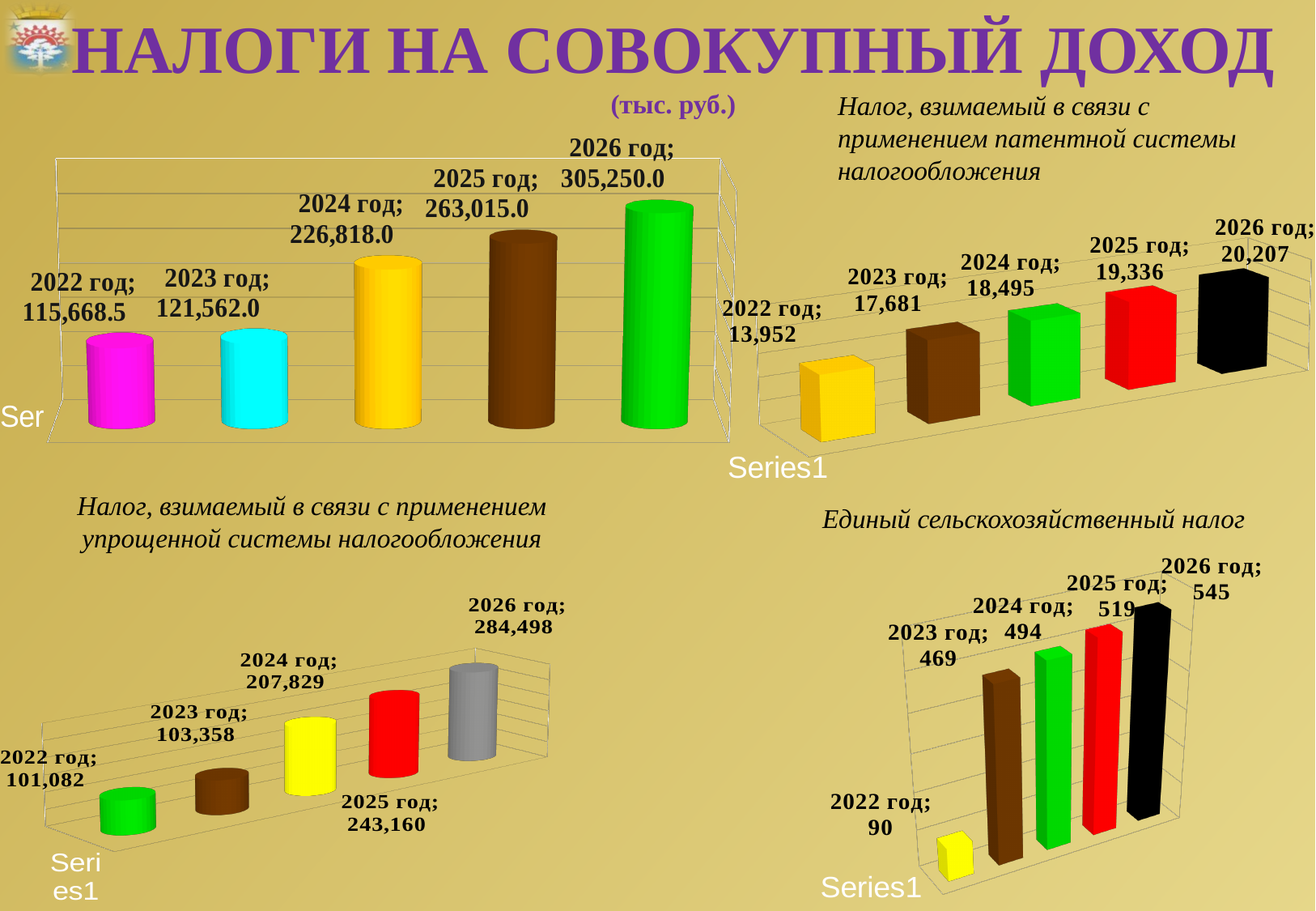
In the chart titled 'Налог, взимаемый в связи с применением упрощенной системы налогообложения', how many years are plotted? 5 In the chart titled 'Единый сельскохозяйственный налог', what is the value for 2022 год? 90 In the top-left chart (taxes on aggregate income, тыс. руб.), what is the difference between the 2025 год and 2024 год values? 36,197.0 In the chart titled 'Налог, взимаемый в связи с применением патентной системы налогообложения', do the values rise or fall from 2022 год to 2026 год? rise In the chart titled 'Налог, взимаемый в связи с применением патентной системы налогообложения', what is the value for 2024 год? 18,495 In the chart titled 'Налог, взимаемый в связи с применением упрощенной системы налогообложения', which year has the highest value? 2026 год In the top-left chart (taxes on aggregate income, тыс. руб.), what is the value for 2026 год? 305,250.0 In the chart titled 'Налог, взимаемый в связи с применением патентной системы налогообложения', which year has the lowest value? 2022 год In the top-left chart (taxes on aggregate income, тыс. руб.), what is the value for 2022 год? 115,668.5 In the chart titled 'Налог, взимаемый в связи с применением упрощенной системы налогообложения', what is the value for 2025 год? 243,160 In the chart titled 'Единый сельскохозяйственный налог', what is the difference between the 2026 год and 2025 год values? 26 What kind of chart is the chart titled 'Единый сельскохозяйственный налог'? bar chart